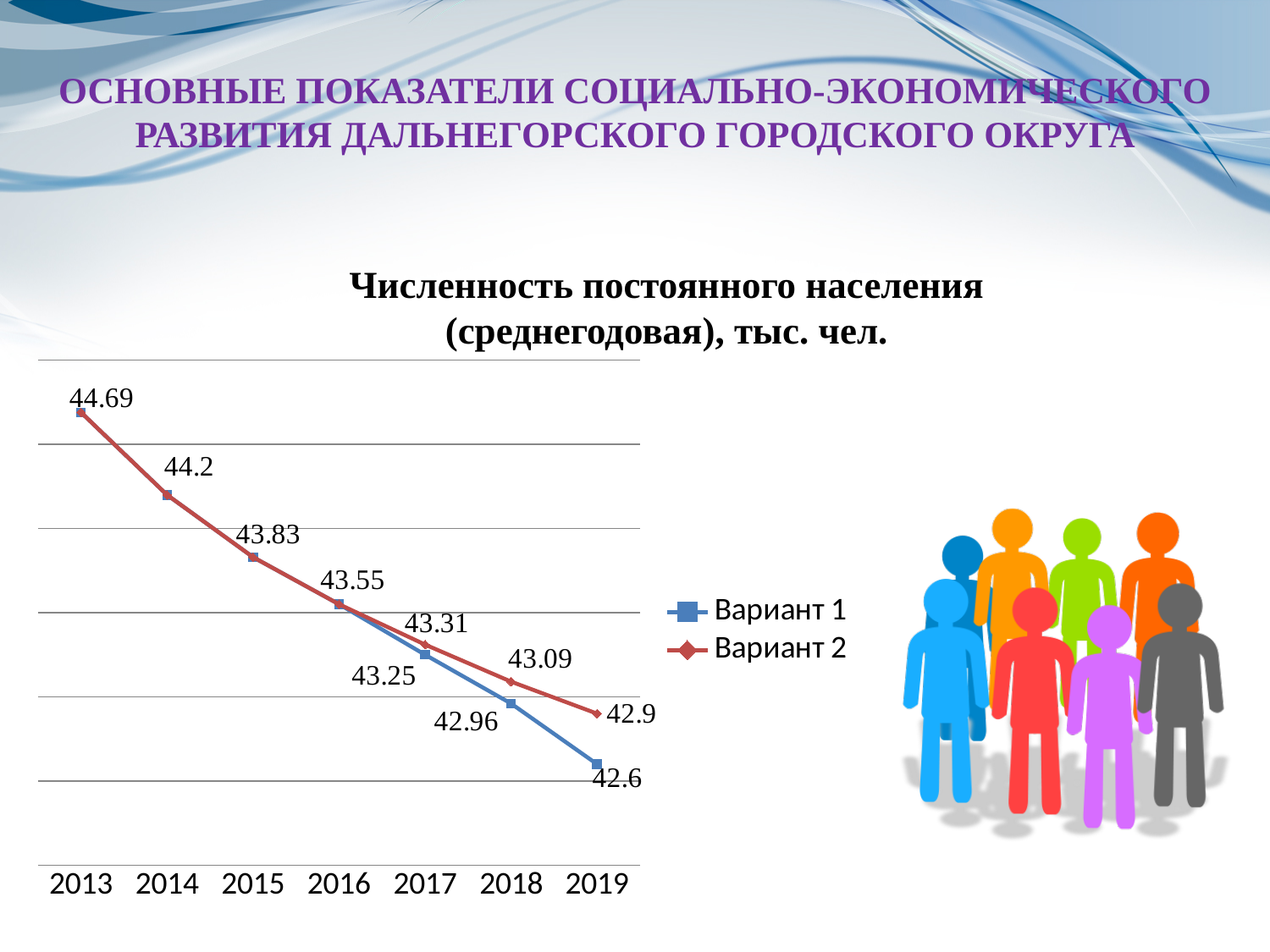
What is the value for Вариант 1 in 2017? 43.25 Do the values rise or fall from 2013 to 2019? fall How many series does the legend list? 2 What is the value for Вариант 2 in 2018? 43.09 How many years are shown on the x axis? 7 What type of chart is shown on the slide? line chart What is the difference between Вариант 2 and Вариант 1 in 2019? 0.3 Which series has the lower value in 2019, Вариант 1 or Вариант 2? Вариант 1 Which year has the highest population value? 2013 What is the value for Вариант 2 in 2019? 42.9 What is the population value for 2013? 44.69 What is the value for Вариант 1 in 2019? 42.6